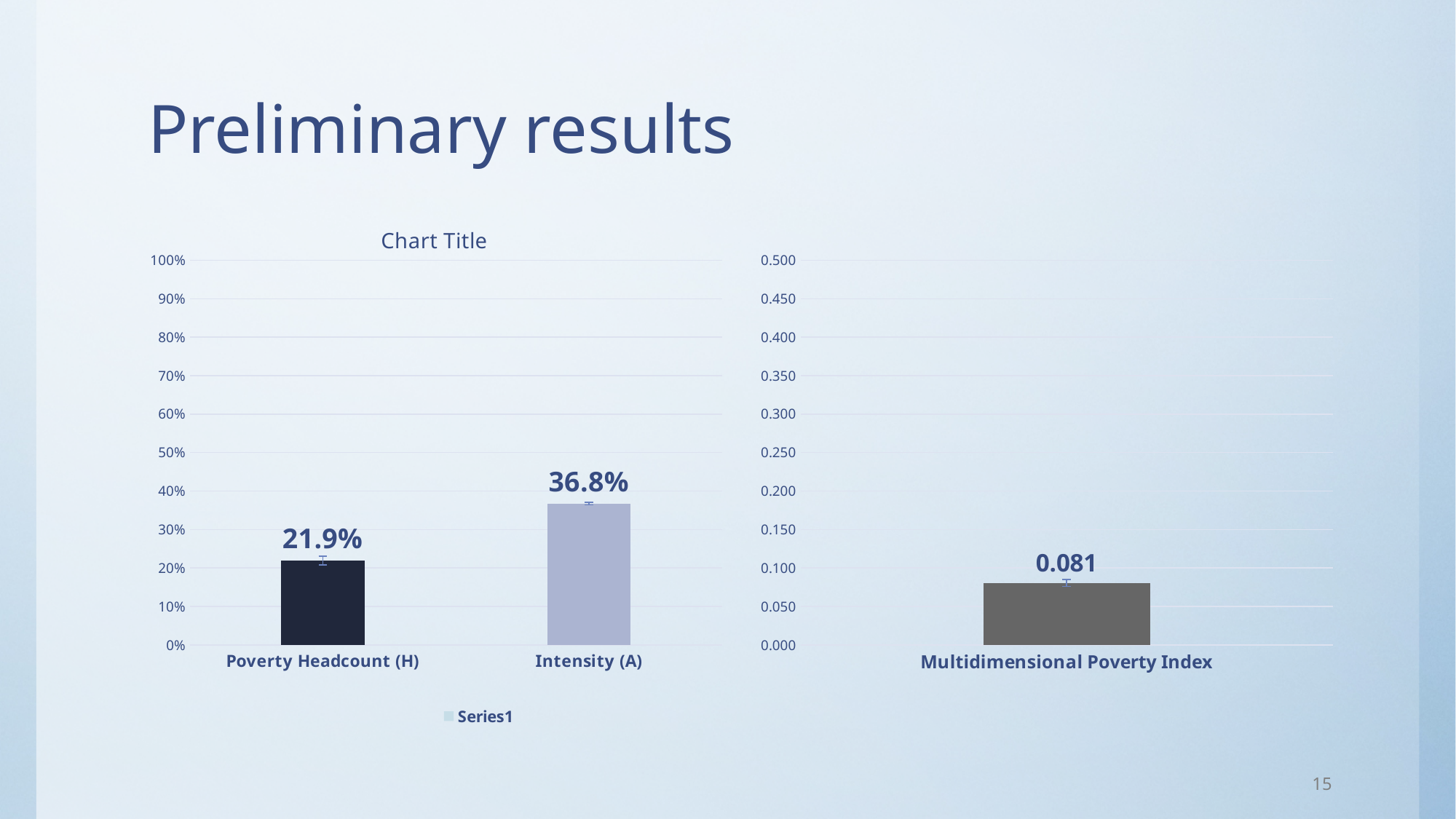
In the left chart titled 'Chart Title', how many categories are shown on the x axis? 2 In the left chart titled 'Chart Title', what is the value for Intensity (A)? 36.8% What kind of chart is the left chart titled 'Chart Title'? Bar chart In the left chart titled 'Chart Title', which is larger: Poverty Headcount (H) or Intensity (A)? Intensity (A) In the left chart titled 'Chart Title', what is the name of the series listed in the legend? Series1 In the left chart titled 'Chart Title', which category has the lowest value? Poverty Headcount (H) In the right chart, is the value for Multidimensional Poverty Index greater or less than 0.100? less In the left chart titled 'Chart Title', what is the difference between the Intensity (A) value and the Poverty Headcount (H) value? 14.9% In the right chart, what is the value for Multidimensional Poverty Index? 0.081 In the left chart titled 'Chart Title', which category has the highest value? Intensity (A) In the right chart, how many bars are plotted? 1 In the left chart titled 'Chart Title', what is the value for Poverty Headcount (H)? 21.9%